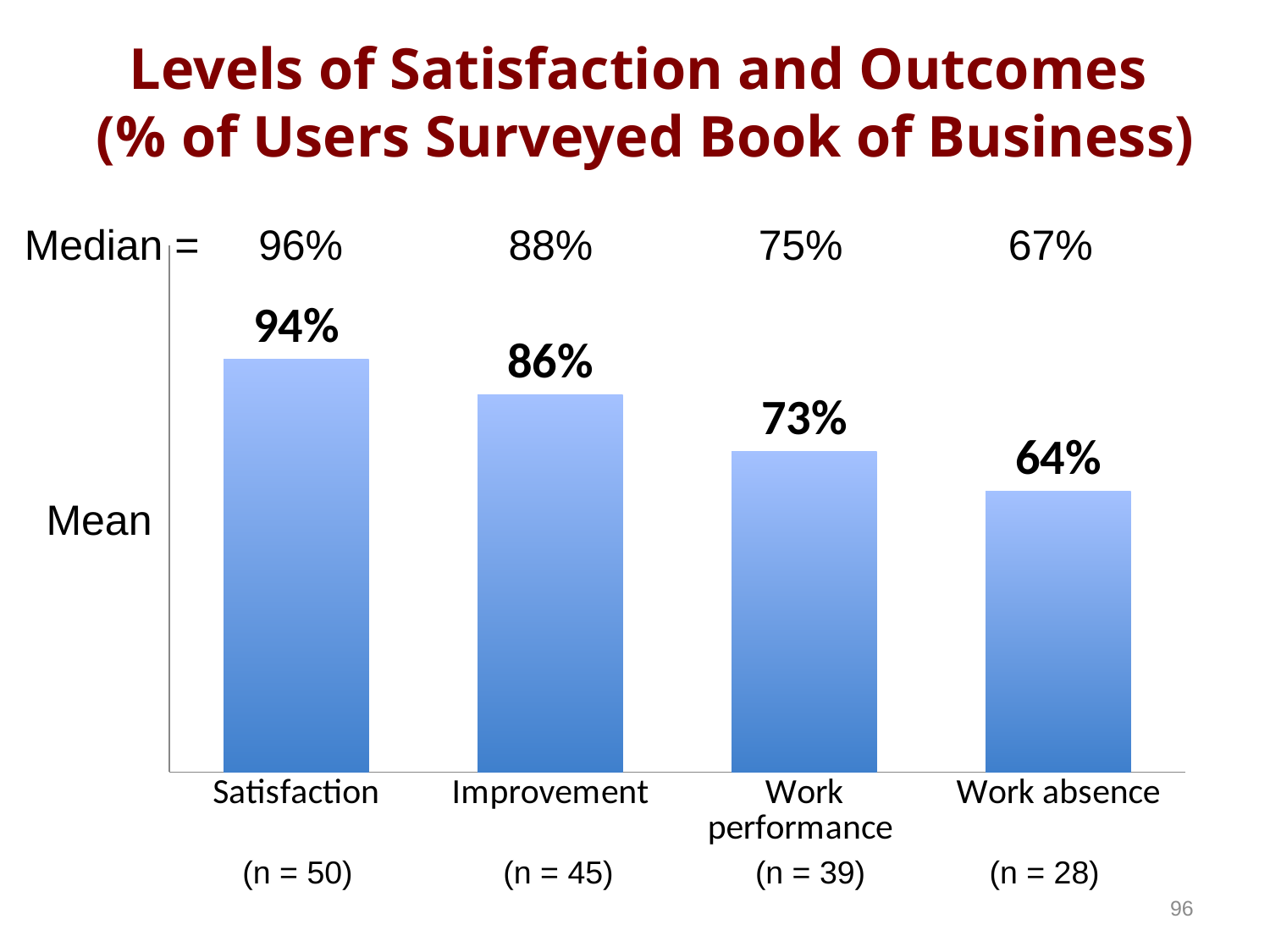
What is the median value shown above the Improvement bar? 88% Do the mean values rise or fall from left to right across the categories? Fall What is the mean value shown for Satisfaction? 94% Which category has the highest mean value? Satisfaction What is the median value shown above the Work performance bar? 75% What is the difference between the mean values for Satisfaction and Work absence? 30% How many categories are shown on the chart? 4 What is the mean value shown for Work absence? 64% What is the difference between the median and mean values for Work performance? 2% Which category has the lowest mean value? Work absence Which has a larger mean value, Improvement or Work performance? Improvement What kind of chart is shown on the slide? Bar chart